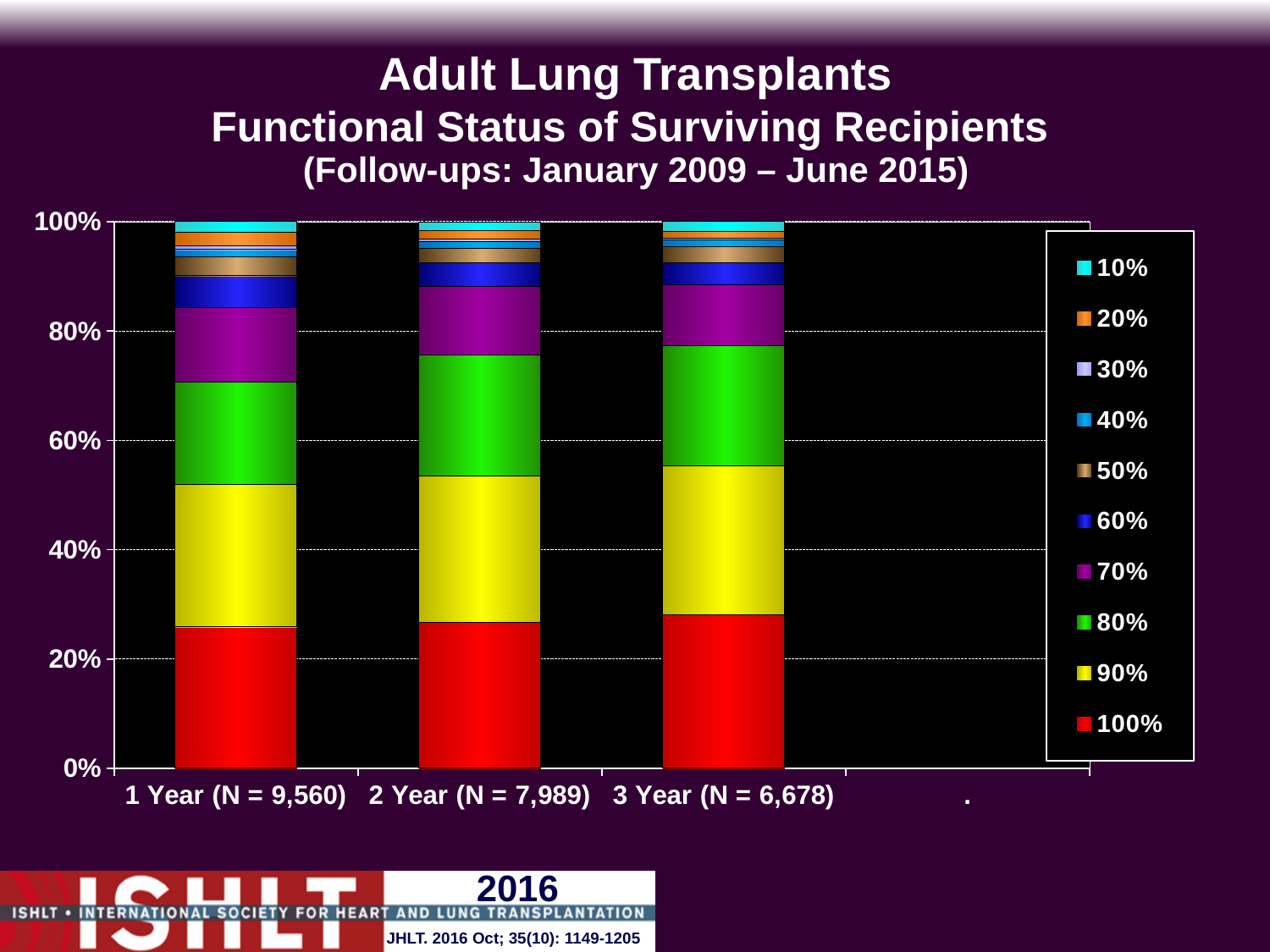
Is the 100% functional status segment for 2 Year (N = 7,989) greater or less than 20%? greater What is the total height of the stacked bar for 1 Year (N = 9,560)? 100% What is the N value shown for the 2 Year category? 7,989 Which colour represents the 100% functional status series in the legend? Red What is the follow-up period stated in the chart title? January 2009 – June 2015 Is the 100% functional status segment for 3 Year (N = 6,678) greater or less than 20%? greater What is the N value shown for the 3 Year category? 6,678 How many series does the legend list? 10 How many bars (follow-up time points) are plotted on the chart? 3 What kind of chart is shown on the slide? Stacked bar chart Is the 100% functional status segment for 1 Year (N = 9,560) greater or less than 40%? less